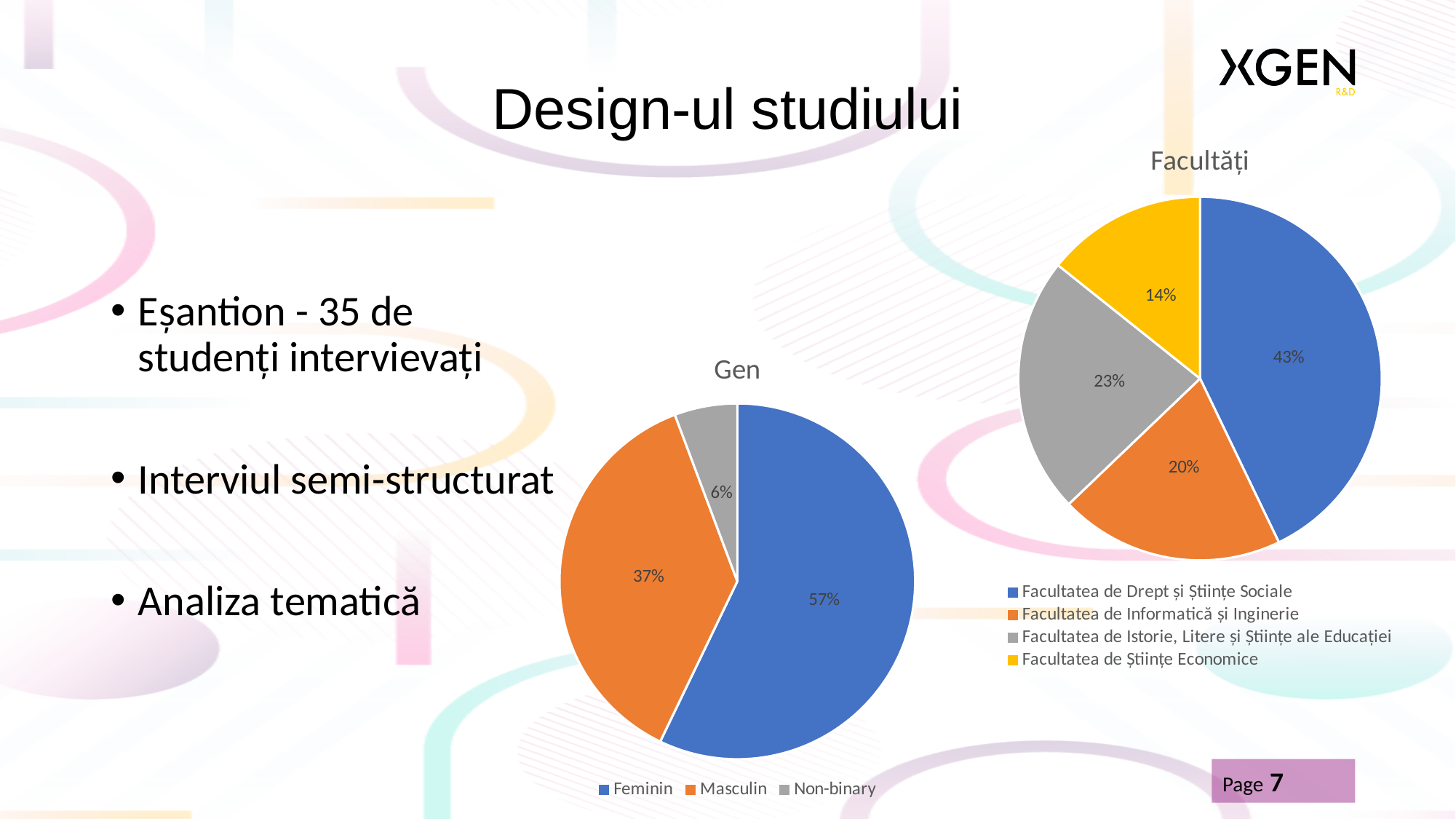
In the 'Facultăți' pie chart, what share is labelled for Facultatea de Științe Economice? 14% In the 'Gen' pie chart, how many categories does the legend list? 3 In the 'Facultăți' pie chart, what share is labelled for Facultatea de Drept și Științe Sociale? 43% What type of chart is the 'Facultăți' chart? Pie chart In the 'Gen' pie chart, which category has the smallest slice? Non-binary In the 'Gen' pie chart, what share is labelled for Masculin? 37% In the 'Facultăți' pie chart, what share is labelled for Facultatea de Informatică și Inginerie? 20% In the 'Facultăți' pie chart, which faculty has the largest slice? Facultatea de Drept și Științe Sociale In the 'Facultăți' pie chart, which is larger: Facultatea de Informatică și Inginerie or Facultatea de Istorie, Litere și Științe ale Educației? Facultatea de Istorie, Litere și Științe ale Educației In the 'Gen' pie chart, what share is labelled for Feminin? 57% In the 'Gen' pie chart, what share is labelled for Non-binary? 6% In the 'Facultăți' pie chart, what is the difference in percentage points between Facultatea de Istorie, Litere și Științe ale Educației and Facultatea de Științe Economice? 9 percentage points